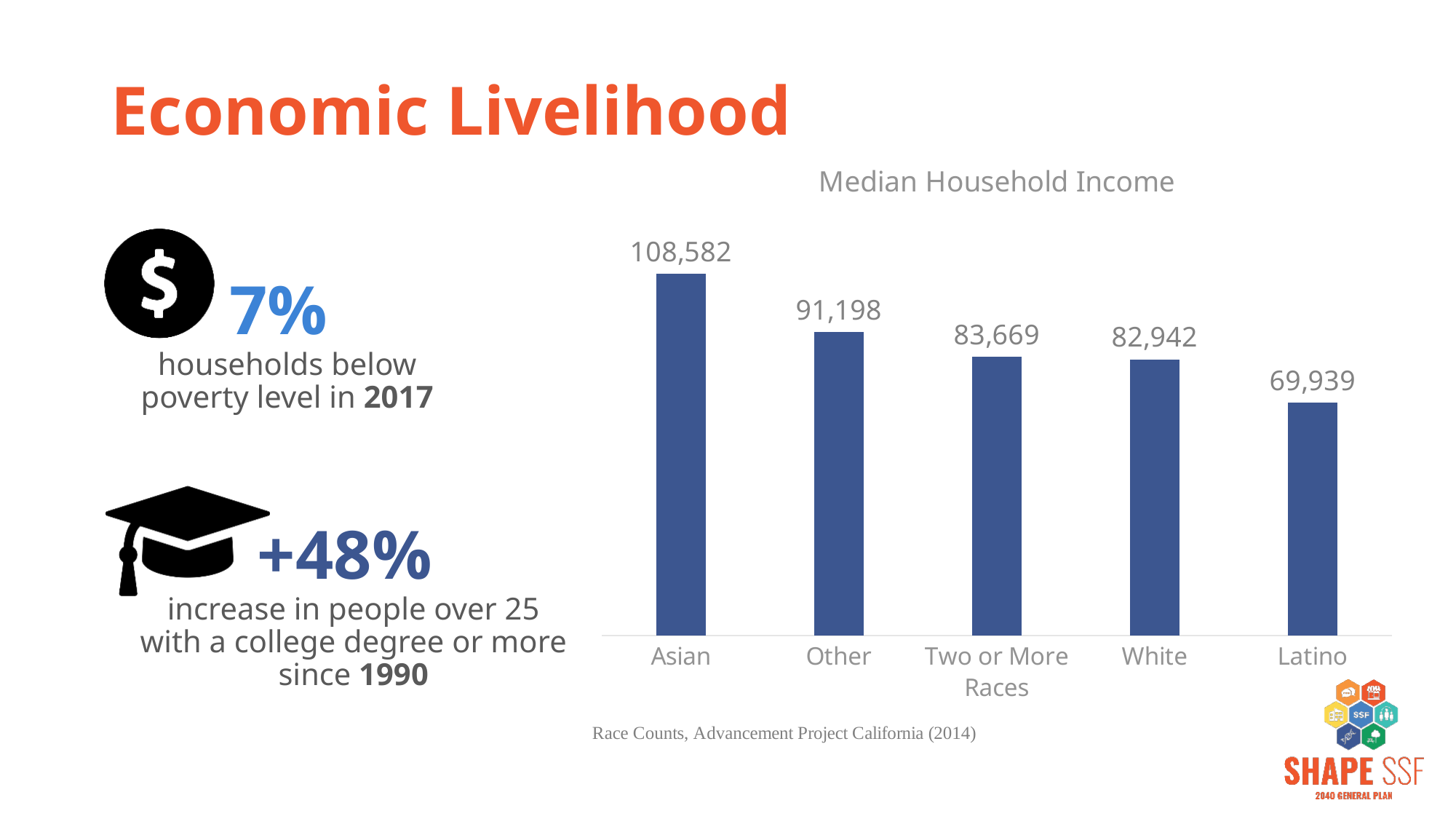
Which category has the highest median household income? Asian What kind of chart is used to show Median Household Income? Bar chart What is the median household income for the Two or More Races category? 83,669 Which has a higher median household income, Other or Latino? Other What is the title of the chart on the slide? Median Household Income What is the median household income for White households? 82,942 How many categories are shown in the Median Household Income chart? 5 What is the median household income for Asian households? 108,582 What is the difference in median household income between Other and White? 8,256 What is the difference in median household income between Asian and Latino households? 38,643 Which category has the lowest median household income? Latino What is the median household income for Latino households? 69,939